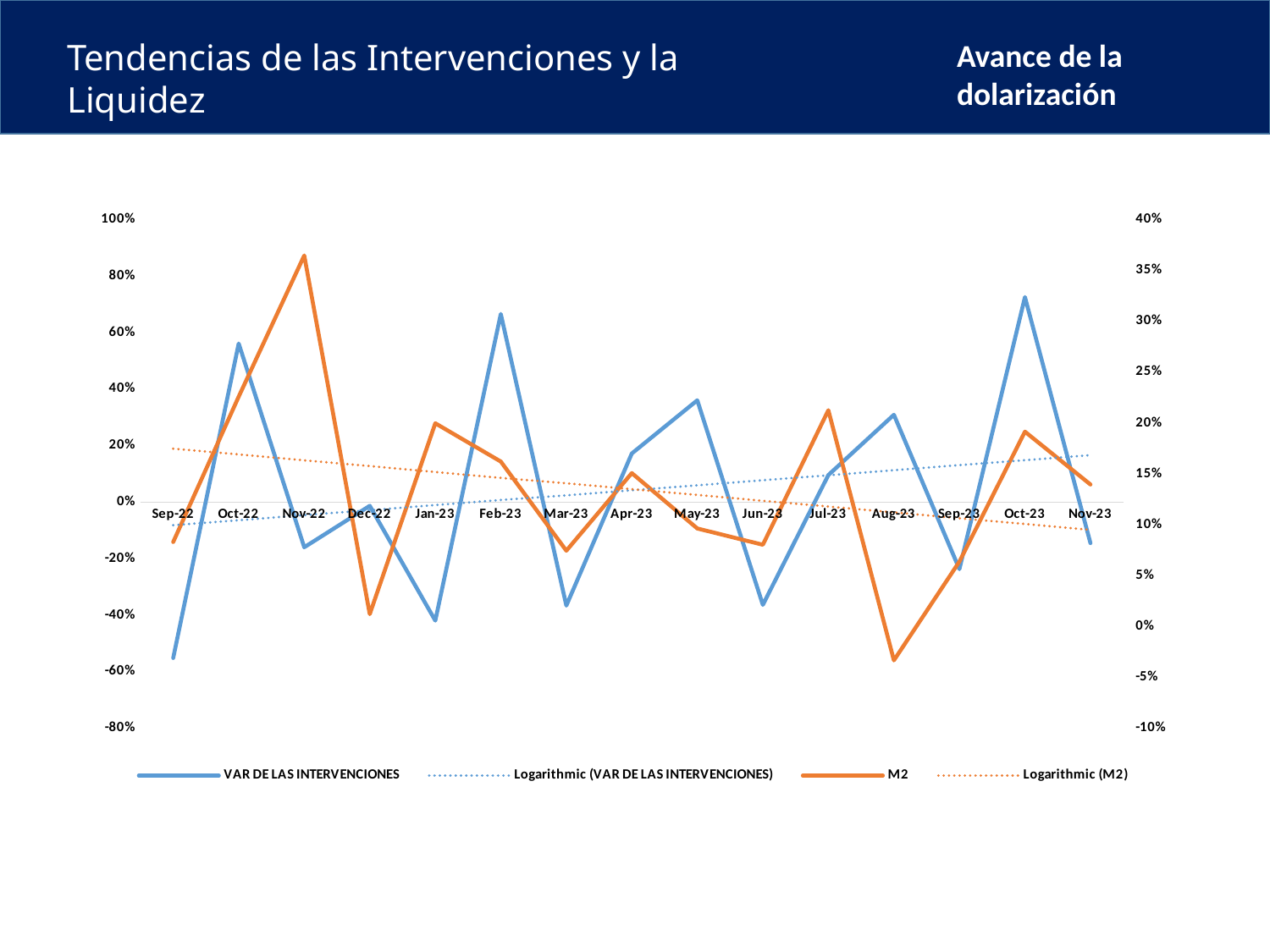
Is the value of VAR DE LAS INTERVENCIONES for Oct-23 greater or less than 60%? greater In which month does VAR DE LAS INTERVENCIONES reach its highest value? Oct-23 How many months are plotted along the x axis? 15 Is the value of M2 for Nov-22 greater or less than 30%? greater In which month does M2 reach its lowest value? Aug-23 Is the value of VAR DE LAS INTERVENCIONES for Sep-22 greater or less than -40%? less In which month does M2 reach its highest value? Nov-22 Which is larger, VAR DE LAS INTERVENCIONES in Oct-22 or in Oct-23? Oct-23 Does the dotted Logarithmic (M2) trendline rise or fall from Sep-22 to Nov-23? Fall What kind of chart is shown on the slide? Line chart How many series does the chart legend list? 4 In which month does VAR DE LAS INTERVENCIONES reach its lowest value? Sep-22